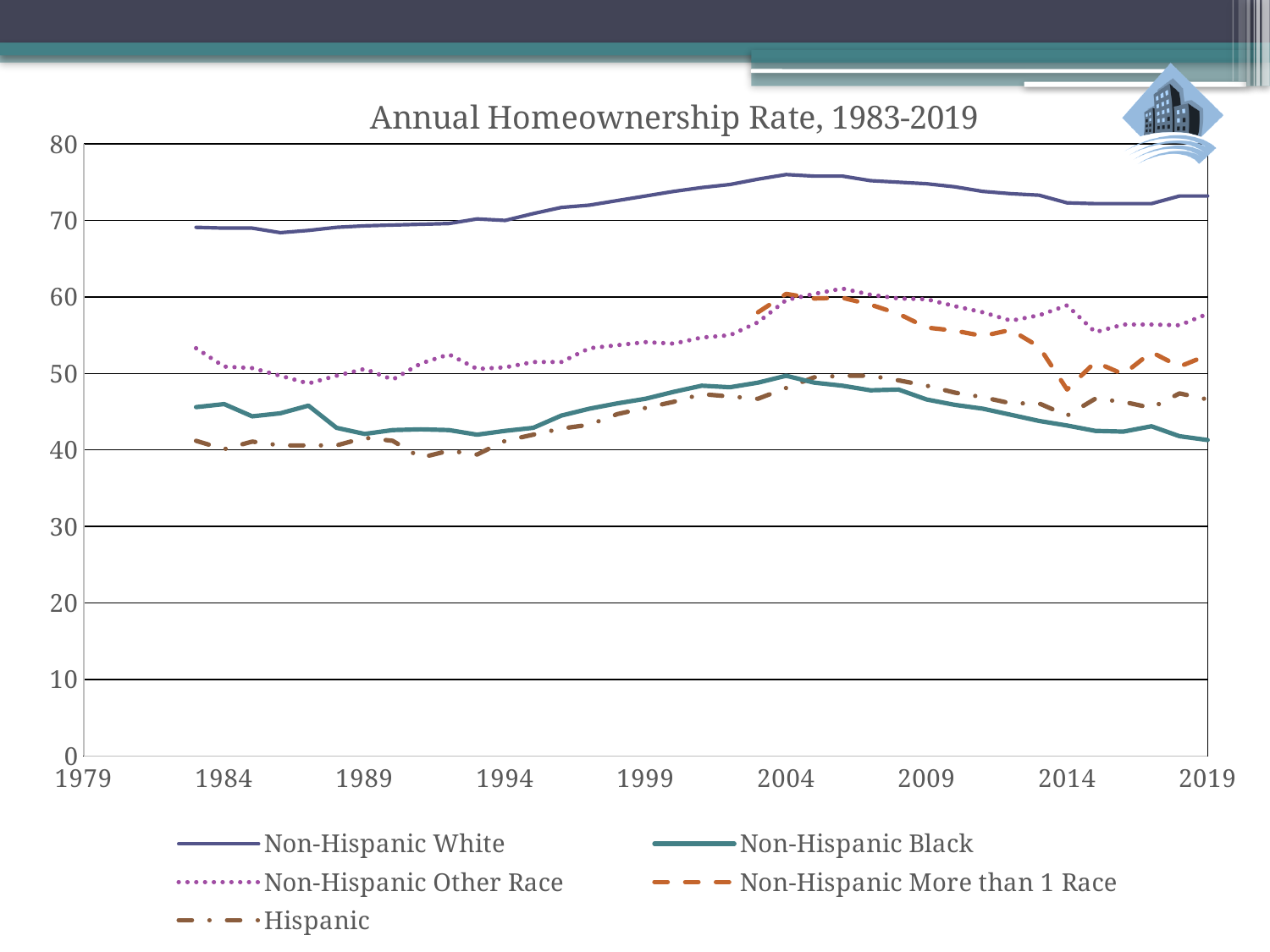
In 2019, which is larger: Non-Hispanic Other Race or Non-Hispanic More than 1 Race? Non-Hispanic Other Race Is the value for Non-Hispanic More than 1 Race in 2004 greater or less than 50? greater Is the value for Non-Hispanic White in 2004 greater or less than 70? greater Does the Non-Hispanic Black homeownership rate rise or fall from 2004 to 2019? fall Which series has the lowest homeownership rate in 2019? Non-Hispanic Black Which series is drawn with an orange dashed line? Non-Hispanic More than 1 Race Is the value for Hispanic in 1984 greater or less than 50? less What is the title of the chart? Annual Homeownership Rate, 1983-2019 What kind of chart is shown on the slide? line chart Which series has the highest homeownership rate across the whole period? Non-Hispanic White How many series does the legend list? 5